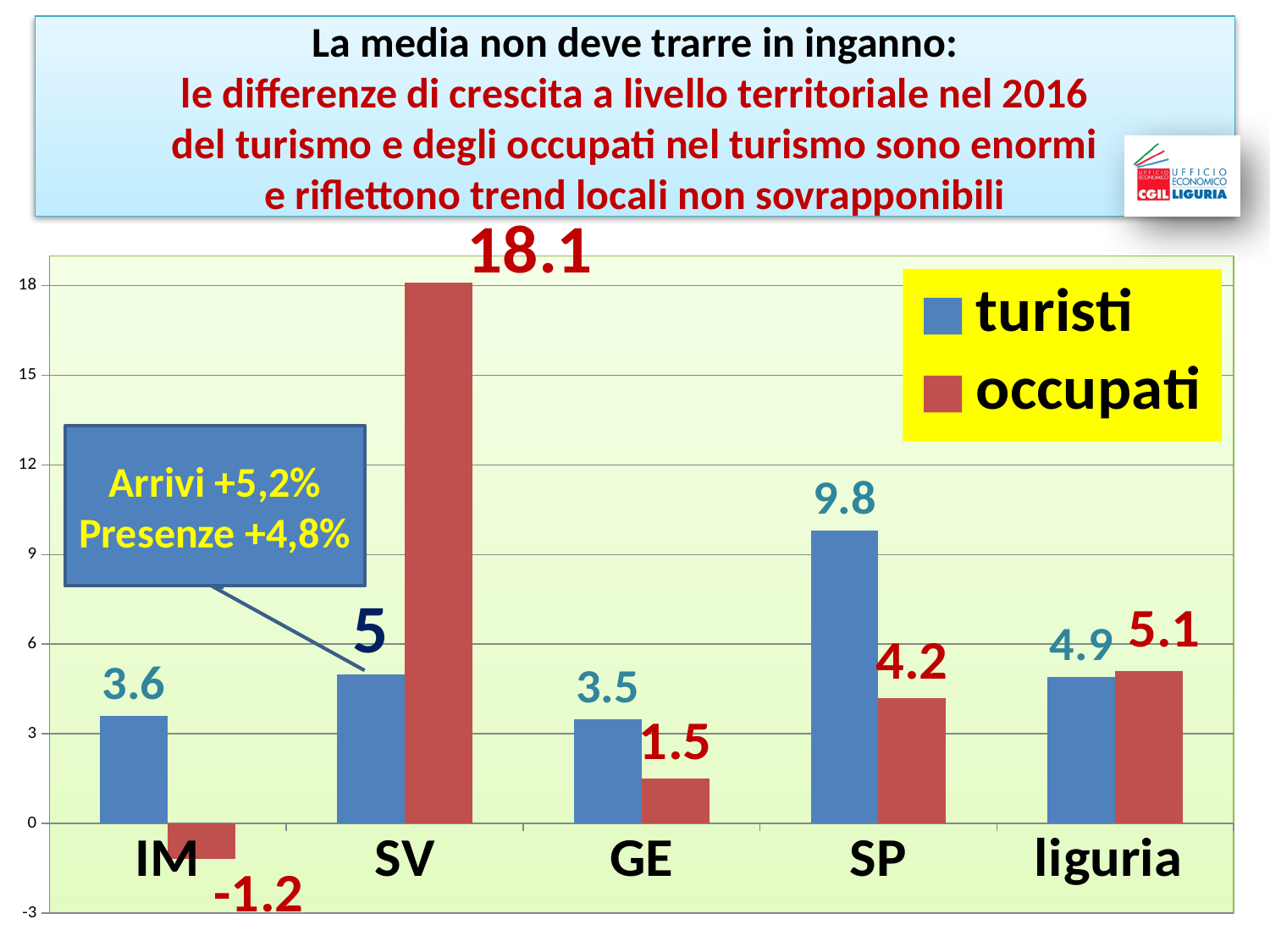
What is the value for turisti in SP? 9.8 What is the value for turisti in liguria? 4.9 What kind of chart is shown on the slide? bar chart How many series does the legend list? 2 How many categories are shown on the x axis? 5 What is the value for occupati in SV? 18.1 Which is larger in GE, turisti or occupati? turisti What colour are the occupati bars? red Which category has the highest occupati value? SV Which category has the lowest turisti value? GE What is the difference between the occupati value and the turisti value in SV? 13.1 What is the value for occupati in IM? -1.2